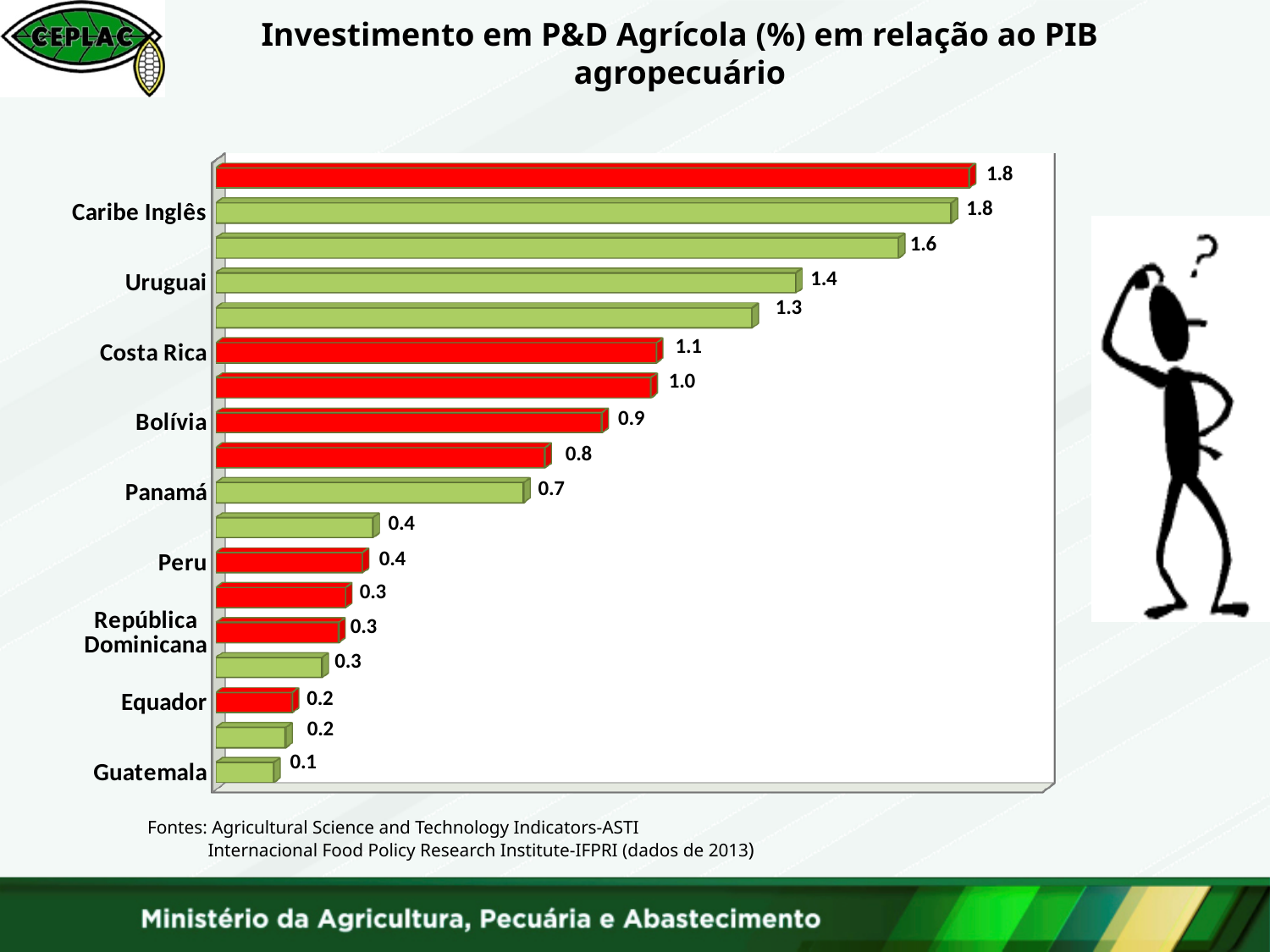
What is the value for Costa Rica? 1.1 What is the value for Bolívia? 0.9 What is the value for Guatemala? 0.1 What is the title of the chart? Investimento em P&D Agrícola (%) em relação ao PIB agropecuário What is the value for Caribe Inglês? 1.8 What is the value for Uruguai? 1.4 Which is larger, the value for Uruguai or the value for Costa Rica? Uruguai What is the difference between the values for Uruguai and Guatemala? 1.3 What is the difference between the values for Costa Rica and Bolívia? 0.2 What kind of chart is shown on the slide? Bar chart How many bars are plotted in the chart? 18 Which labelled country has the lowest value? Guatemala